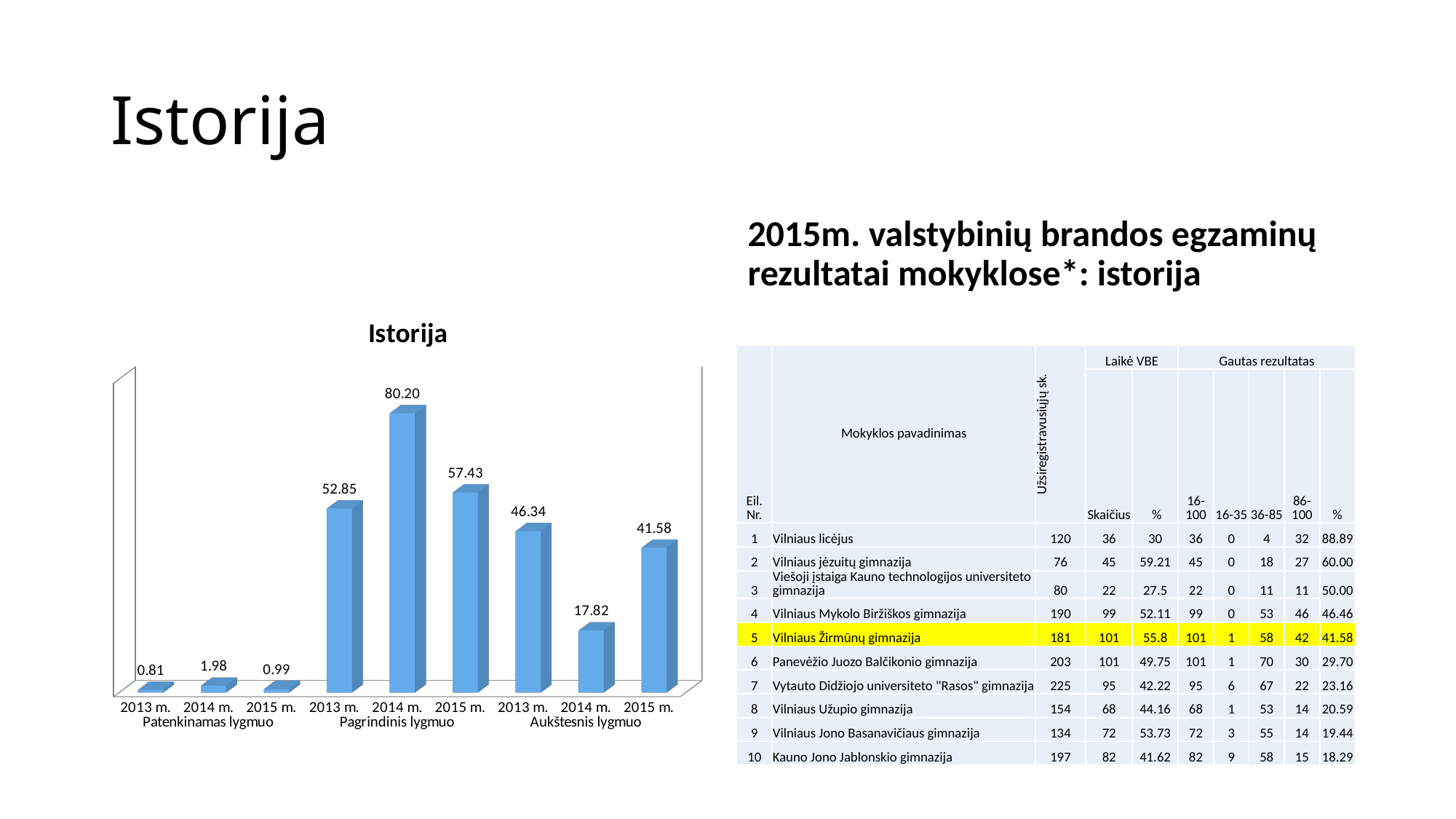
Which bar has the highest value in the chart? 2014 m., Pagrindinis lygmuo What is the title of the chart? Istorija Which is larger: the 2013 m. value in Aukštesnis lygmuo or the 2015 m. value in Aukštesnis lygmuo? 2013 m. (46.34) What type of chart is shown on the slide? bar chart How many bars are plotted in the chart? 9 Within the Aukštesnis lygmuo group, do the values rise or fall from 2013 m. to 2014 m.? fall What is the value for 2015 m. in the Aukštesnis lygmuo group? 41.58 Which bar has the lowest value in the chart? 2013 m., Patenkinamas lygmuo What is the difference between the 2014 m. and 2013 m. values in the Pagrindinis lygmuo group? 27.35 How many level groups are shown along the x axis of the chart? 3 What is the value for 2013 m. in the Patenkinamas lygmuo group? 0.81 What is the value for 2014 m. in the Pagrindinis lygmuo group? 80.20